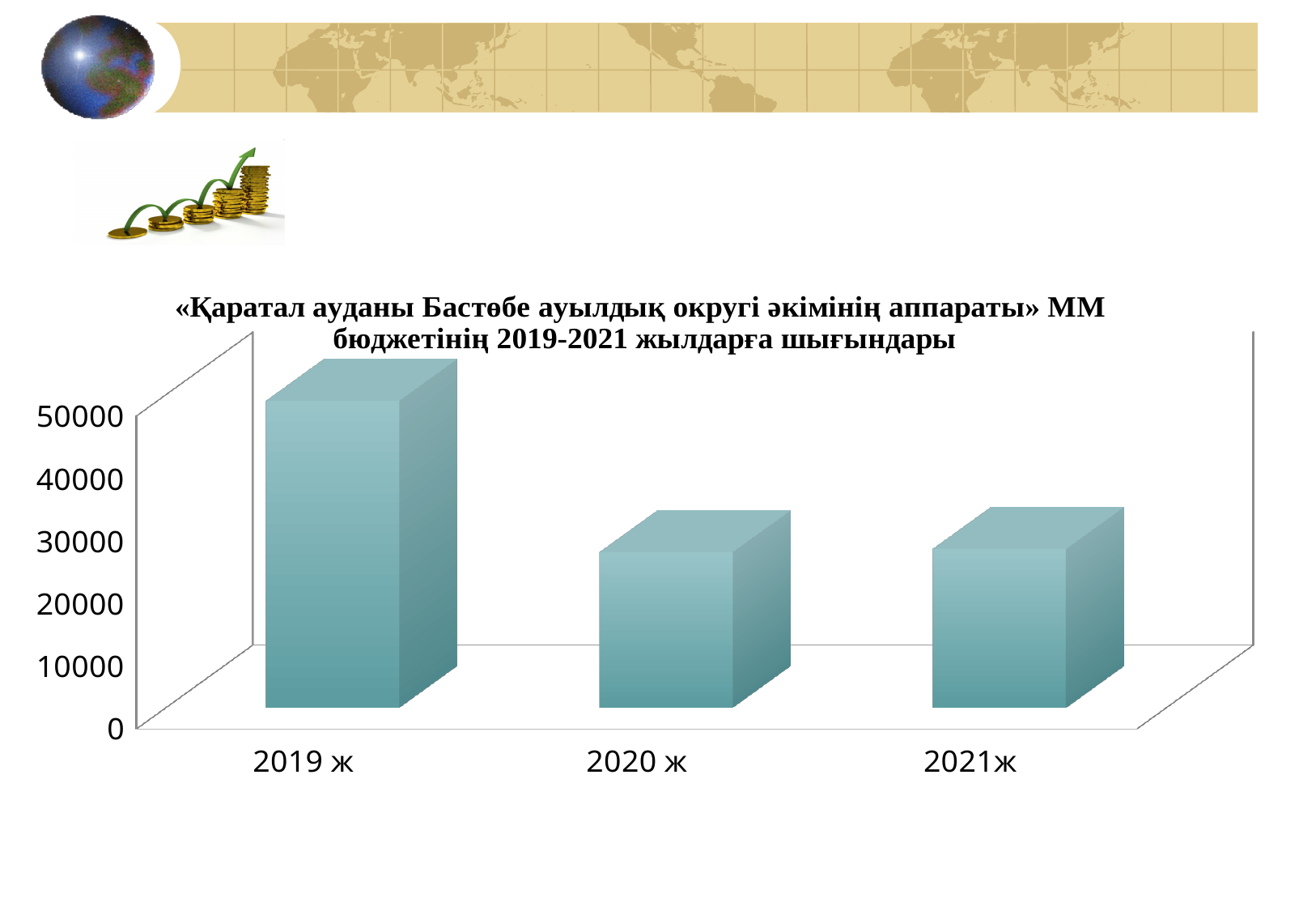
Which is larger, the value for 2019 ж or the value for 2021ж? 2019 ж Is the value for 2021ж greater or less than 20000? greater Which years does the chart title say the budget expenditures cover? 2019-2021 Is the value for 2019 ж greater or less than 40000? greater How many categories (years) are shown on the x axis of the chart? 3 Which year has the highest value in the chart? 2019 ж Is the value for 2020 ж greater or less than 20000? greater Does the value rise or fall from 2019 ж to 2020 ж? fall What kind of chart is shown on the slide? bar chart Which is larger, the value for 2019 ж or the value for 2020 ж? 2019 ж